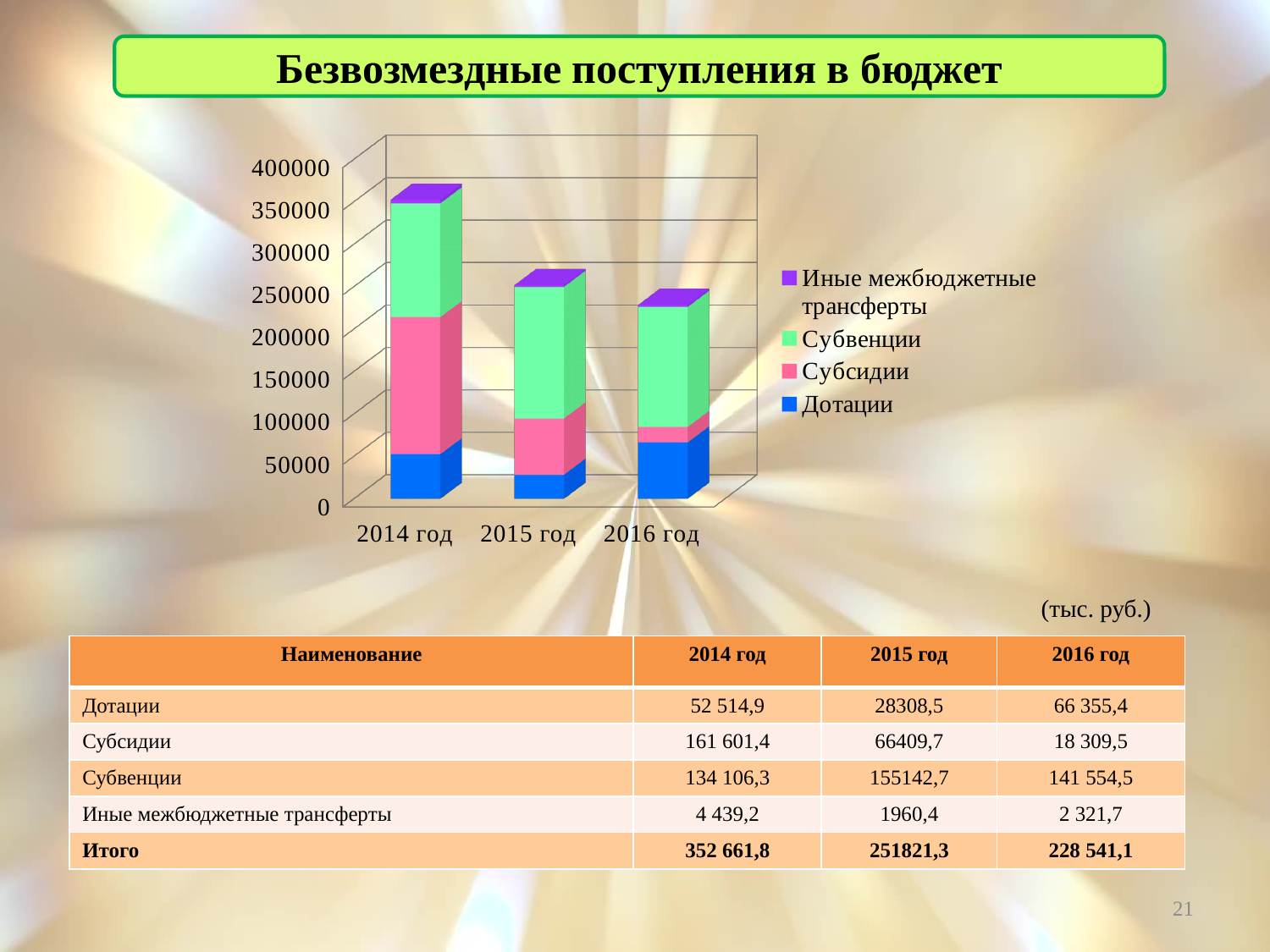
Which year has the lowest total of безвозмездные поступления? 2016 год Which is larger, Субсидии in 2014 год or Субсидии in 2016 год? 2014 год What is the total (Итого) of the stacked bar for 2014 год? 352 661,8 What is the value of Субвенции for 2015 год? 155142,7 Which year has the highest total of безвозмездные поступления? 2014 год Is the total bar for 2015 год greater or less than 200000? greater How many series does the chart legend list? 4 How many years (categories) are shown on the x axis of the chart? 3 What is the value of Иные межбюджетные трансферты for 2016 год? 2 321,7 What is the value of Дотации for 2014 год? 52 514,9 What kind of chart is shown on the slide? Stacked bar chart Do the total bar heights rise or fall from 2014 год to 2016 год? Fall